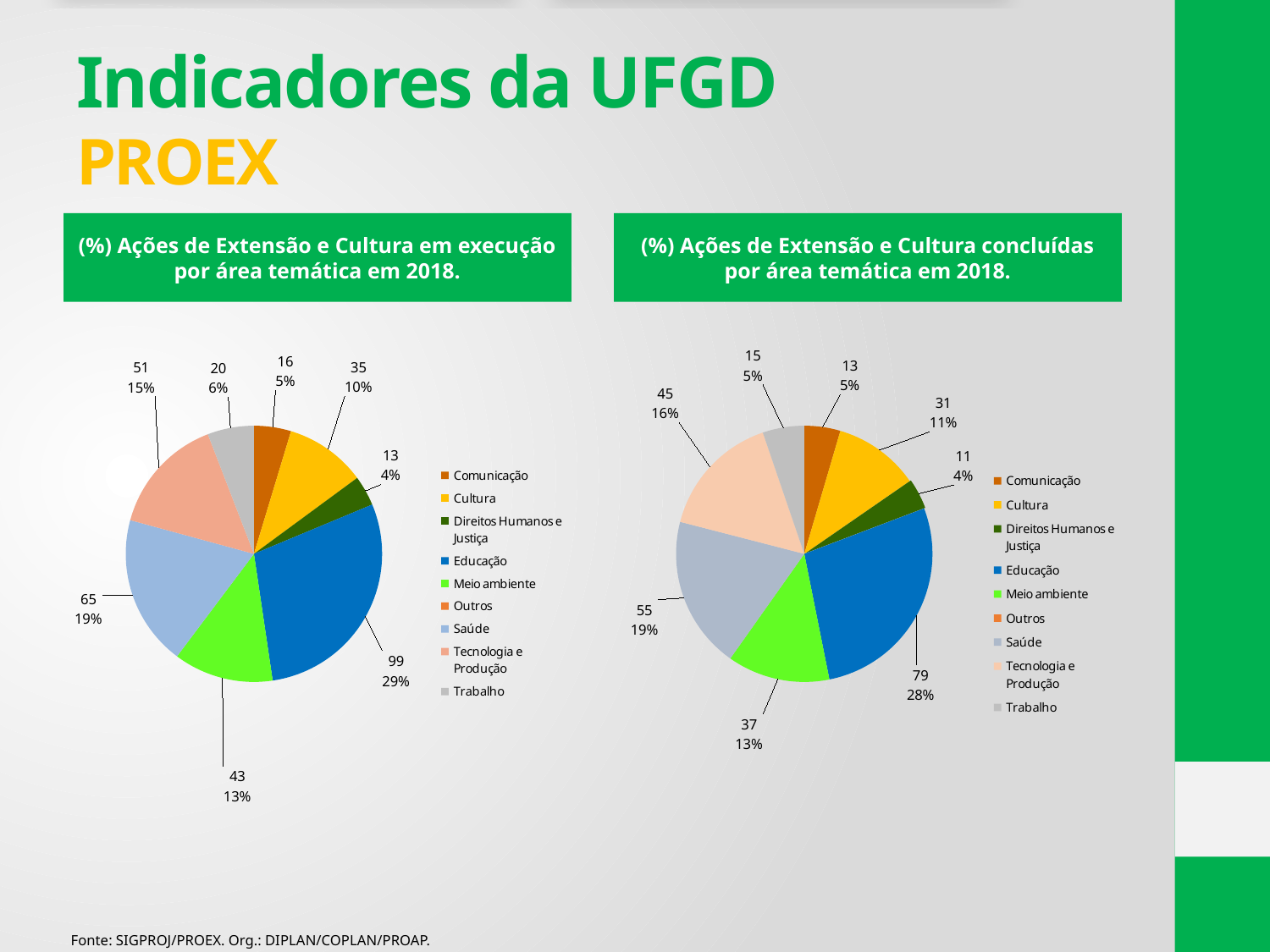
In the left chart (ações em execução), what percentage share does Educação have? 29% What type of chart is used on this slide? Pie chart How many entries does the legend of the left chart list? 9 In the left chart (ações em execução), which thematic area has the largest slice? Educação In the right chart (ações concluídas), which thematic area has the largest slice? Educação In the right chart (ações concluídas), which is larger, the value for Cultura or the value for Saúde? Saúde In the right chart (ações concluídas), what is the difference between the values for Saúde and Meio ambiente? 18 In the right chart (ações concluídas), what is the value for Tecnologia e Produção? 45 In the left chart (ações em execução), which labelled thematic area has the smallest slice? Direitos Humanos e Justiça In the right chart (ações concluídas), what percentage share does Meio ambiente have? 13% In the left chart (ações em execução), what is the value for Saúde? 65 In the left chart (ações em execução), what is the difference between the values for Educação and Saúde? 34